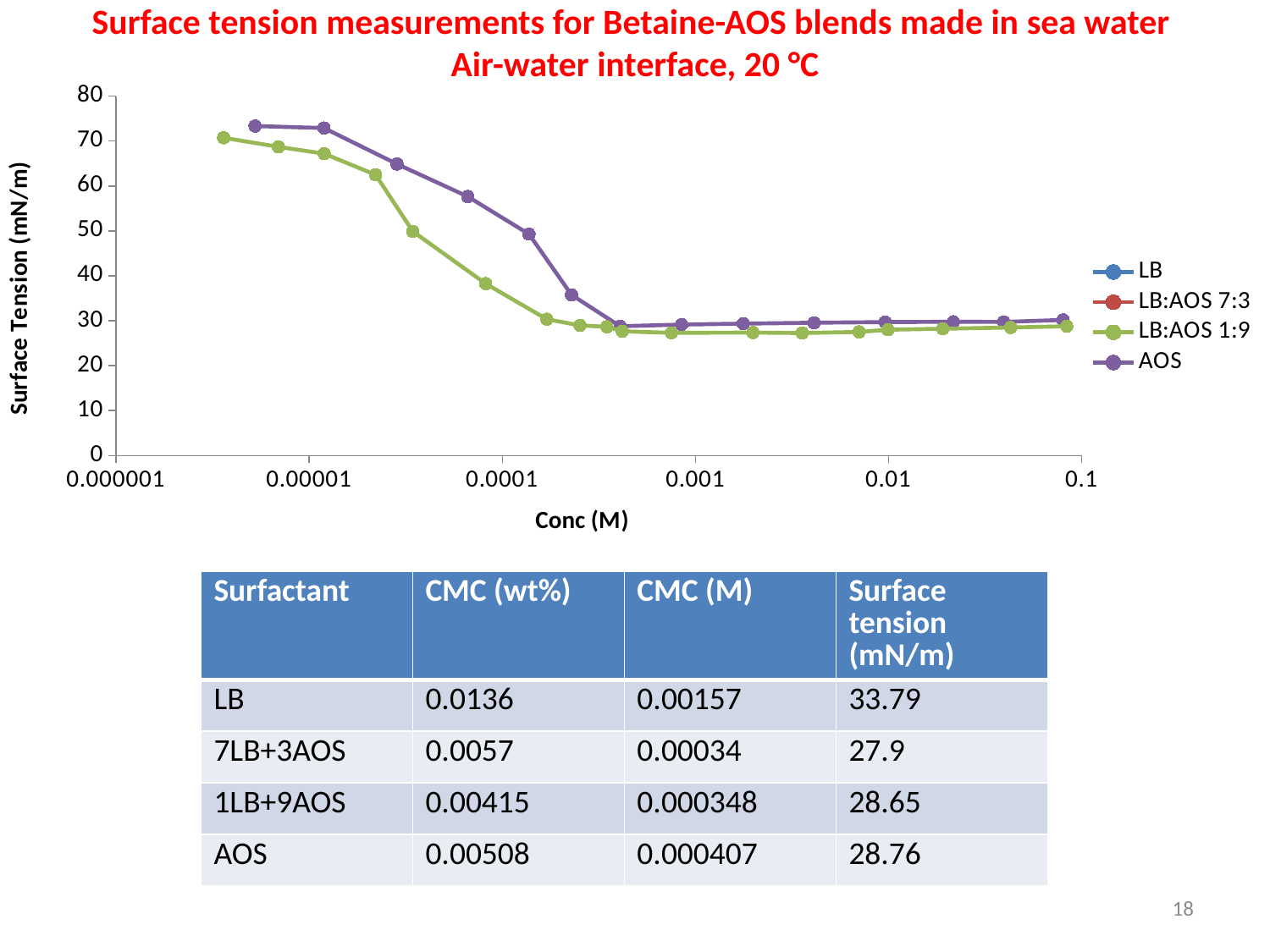
What kind of chart is shown on the slide? line chart How many series does the chart legend list? 4 Is the surface tension for LB:AOS 1:9 at a concentration of 0.00001 M greater or less than 60 mN/m? greater What is the label of the x axis of the chart? Conc (M) As concentration increases from 0.000001 M to 0.0001 M, does the surface tension for AOS rise or fall? fall Is the surface tension for AOS at its lowest plotted concentration greater or less than 60 mN/m? greater Is the surface tension for LB:AOS 1:9 at a concentration of 0.01 M greater or less than 30 mN/m? less What is the label of the y axis of the chart? Surface Tension (mN/m) Which plotted series reaches the highest surface tension on the chart? AOS At a concentration of 0.0001 M, which series has the higher surface tension, AOS or LB:AOS 1:9? AOS